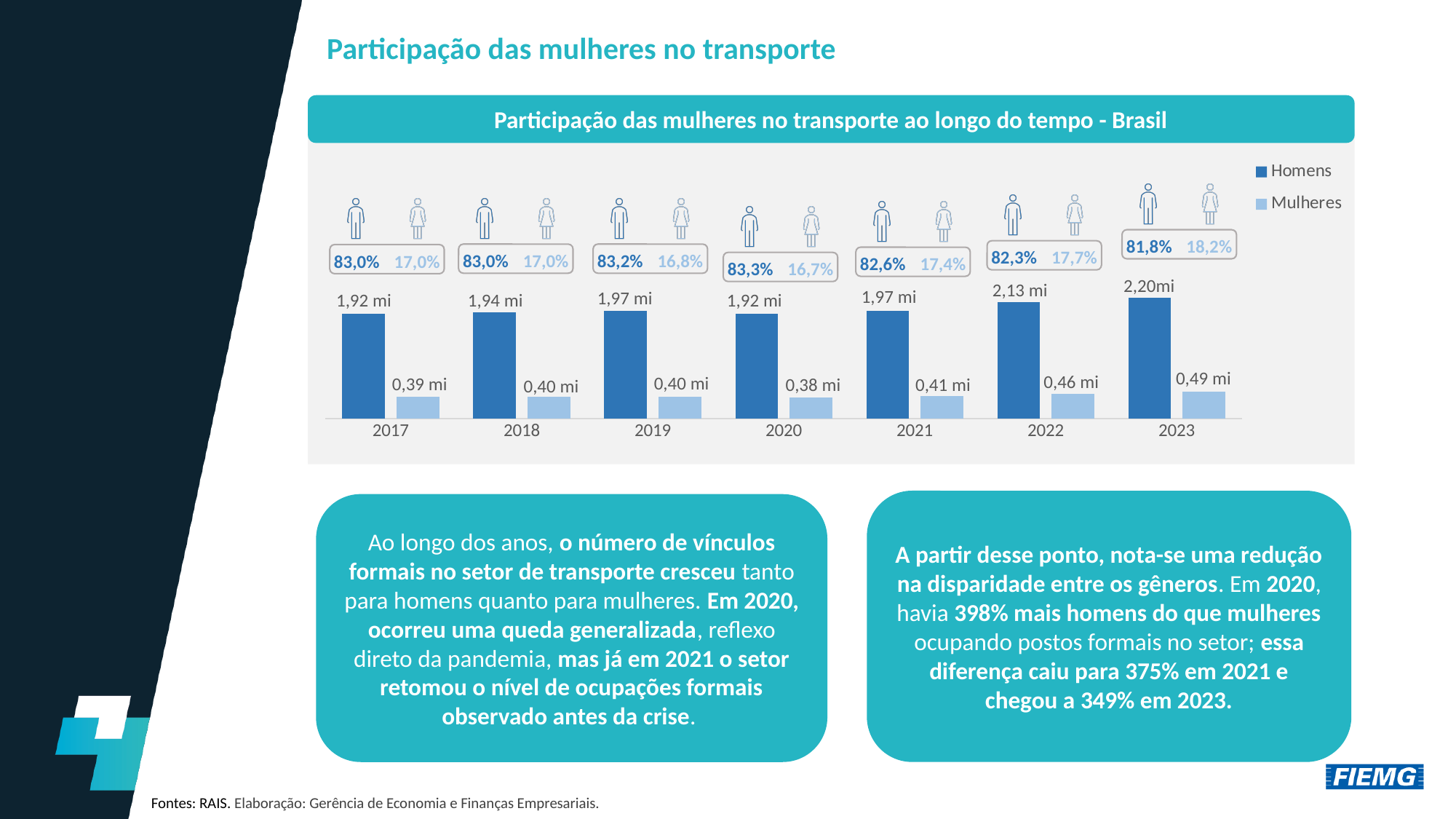
Does the Mulheres percentage share rise or fall from 2020 to 2023? Rise How many years are shown on the x axis? 7 What percentage share is shown for Homens in 2020? 83,3% What is the value for Homens in 2023? 2,20mi Which is larger, the Homens value in 2019 or the Homens value in 2020? 2019 In which year is the Mulheres value lowest? 2020 What kind of chart is shown? Bar chart In which year is the Mulheres value highest? 2023 What is the difference between the Homens values in 2023 and 2022? 0,07 mi How many series does the legend list? 2 What is the value for Mulheres in 2020? 0,38 mi What percentage share is shown for Mulheres in 2023? 18,2%